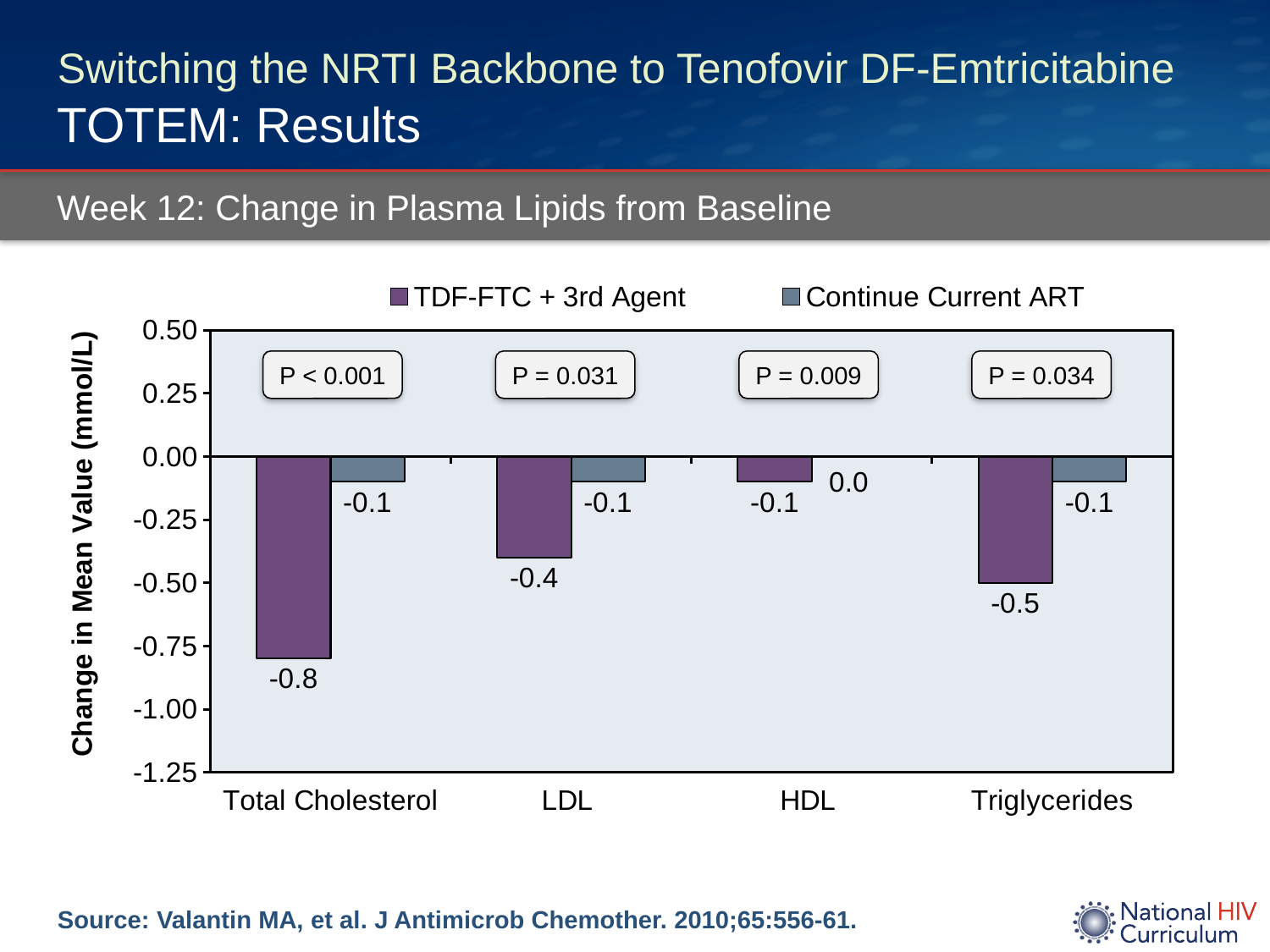
What is the difference between the TDF-FTC + 3rd Agent and Continue Current ART values for Total Cholesterol? 0.7 How many lipid categories are shown on the x axis? 4 What is the change in mean value for Total Cholesterol in the TDF-FTC + 3rd Agent group? -0.8 What is the change in mean value for LDL in the TDF-FTC + 3rd Agent group? -0.4 What P value is shown above the Total Cholesterol bars? P < 0.001 Which lipid category shows the smallest change in the TDF-FTC + 3rd Agent group? HDL How many series does the legend list? 2 What kind of chart is shown on the slide? Bar chart What is the change in mean value for Triglycerides in the TDF-FTC + 3rd Agent group? -0.5 For LDL, which group shows the larger decrease: TDF-FTC + 3rd Agent or Continue Current ART? TDF-FTC + 3rd Agent What is the change in mean value for HDL in the Continue Current ART group? 0.0 Which lipid category shows the largest decrease in the TDF-FTC + 3rd Agent group? Total Cholesterol